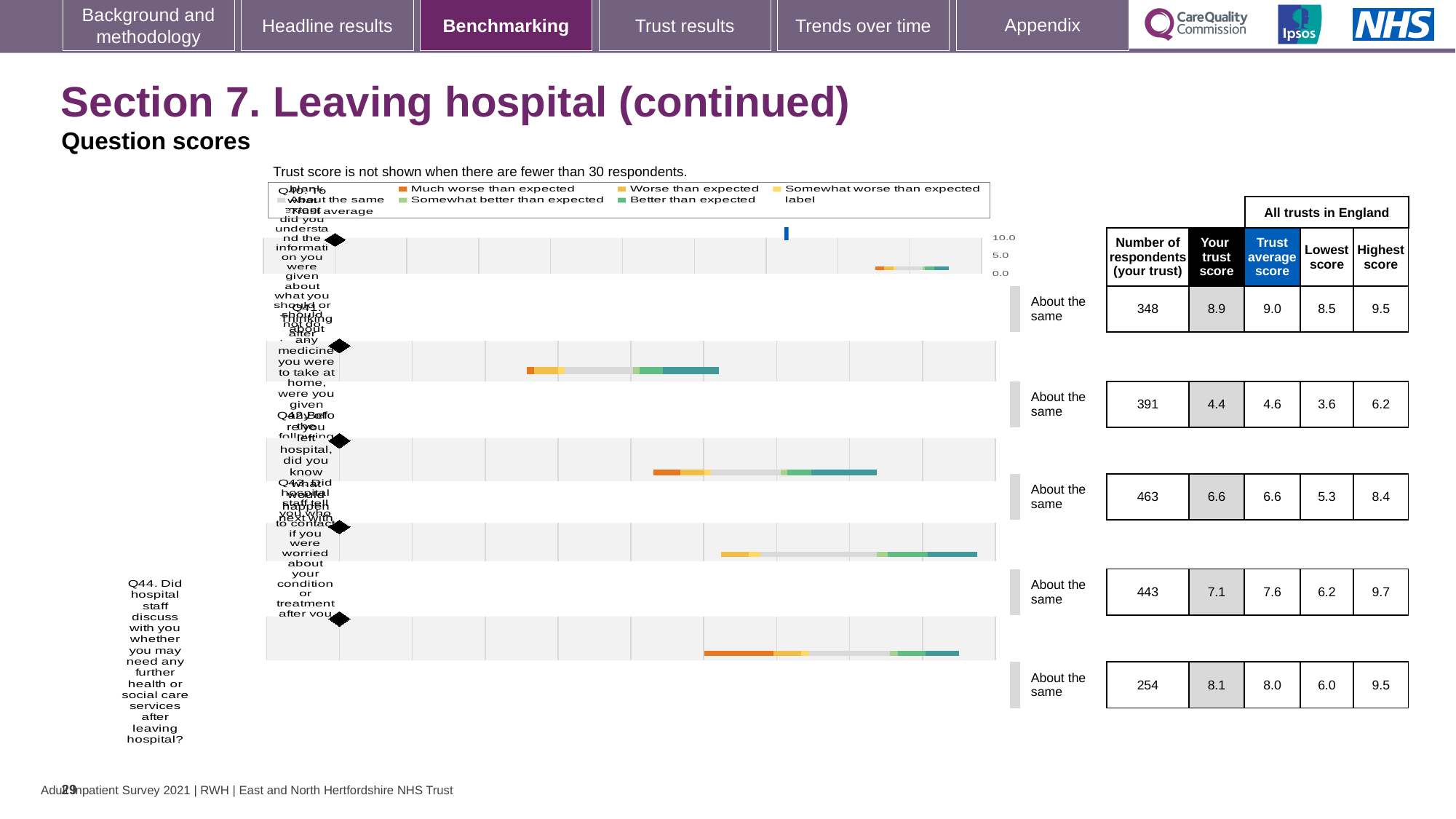
How many respondents (your trust) are shown for Q42 (the third row of the chart)? 463 What is the 'Your trust score' for Q44 (the bottom row of the chart)? 8.1 Which question row has the fewest respondents (your trust)? Q44 (bottom row), 254 What is the 'Trust average score' for Q41 (the second row of the chart)? 4.6 How many question rows are plotted in the chart? 5 For Q44 (the bottom row), which is larger: 'Your trust score' or 'Trust average score'? Your trust score (8.1) What benchmark category is shown for every question row in the chart? About the same What is the 'Highest score' across all trusts in England for Q43 (the fourth row of the chart)? 9.7 What is the difference between the 'Trust average score' and 'Your trust score' for Q43 (the fourth row)? 0.5 What kind of chart is used to show the question scores? Bar chart Which question row has the lowest 'Your trust score'? Q41 (second row), 4.4 Which question row has the highest 'Your trust score'? Q40 (top row), 8.9